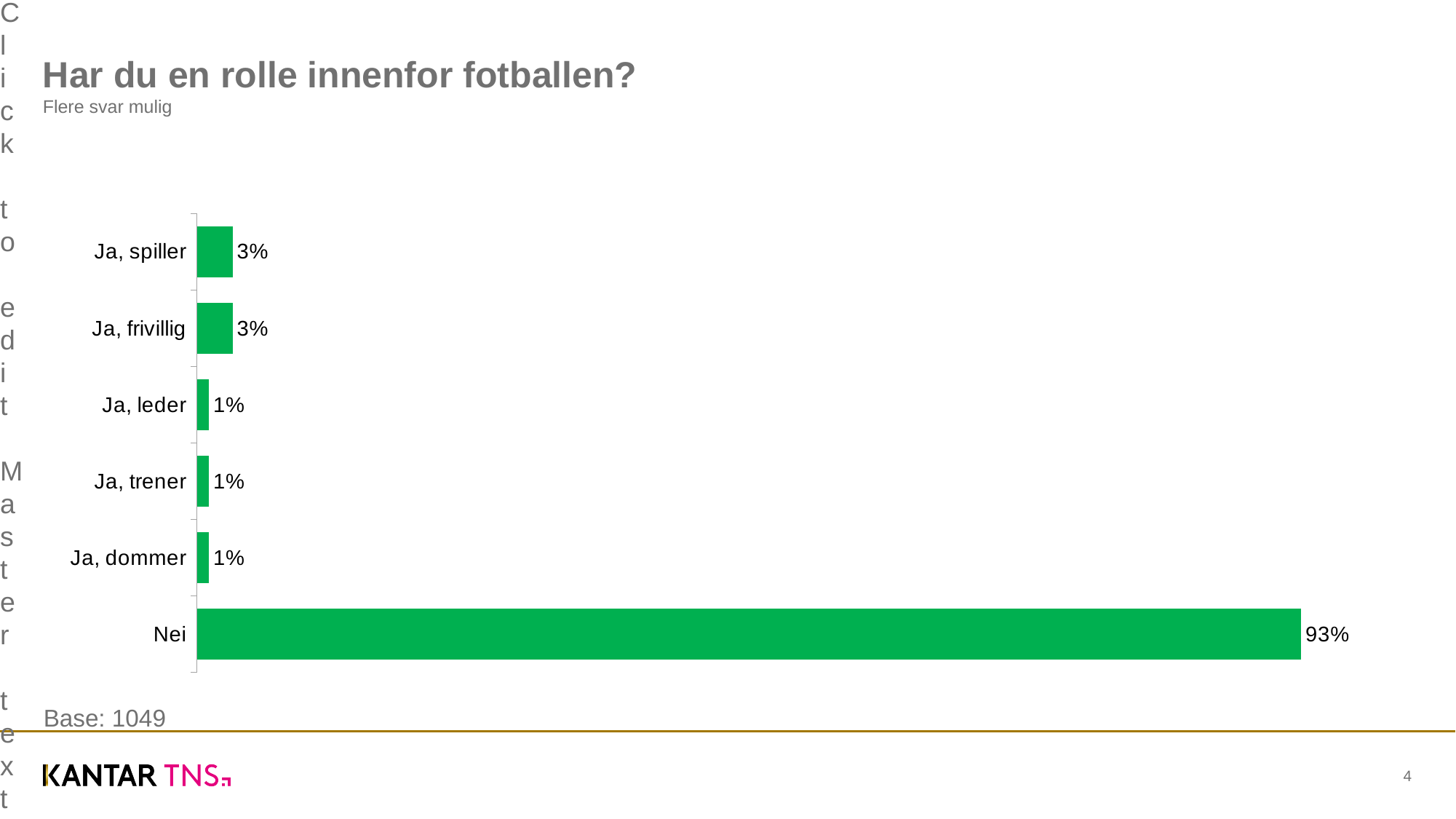
Which category has the highest value? Nei How many categories are shown in the chart? 6 What kind of chart is shown on the slide? Bar chart What percentage of respondents answered "Nei"? 93% What is the base (number of respondents) stated on the slide? 1049 What is the value for "Ja, leder"? 1% What is the difference between the values for "Ja, frivillig" and "Ja, trener"? 2% What is the value for "Ja, frivillig"? 3% What is the title of the slide? Har du en rolle innenfor fotballen? What is the value for "Ja, spiller"? 3% What is the difference between the values for "Nei" and "Ja, spiller"? 90% Which is larger, the value for "Ja, spiller" or the value for "Ja, dommer"? Ja, spiller